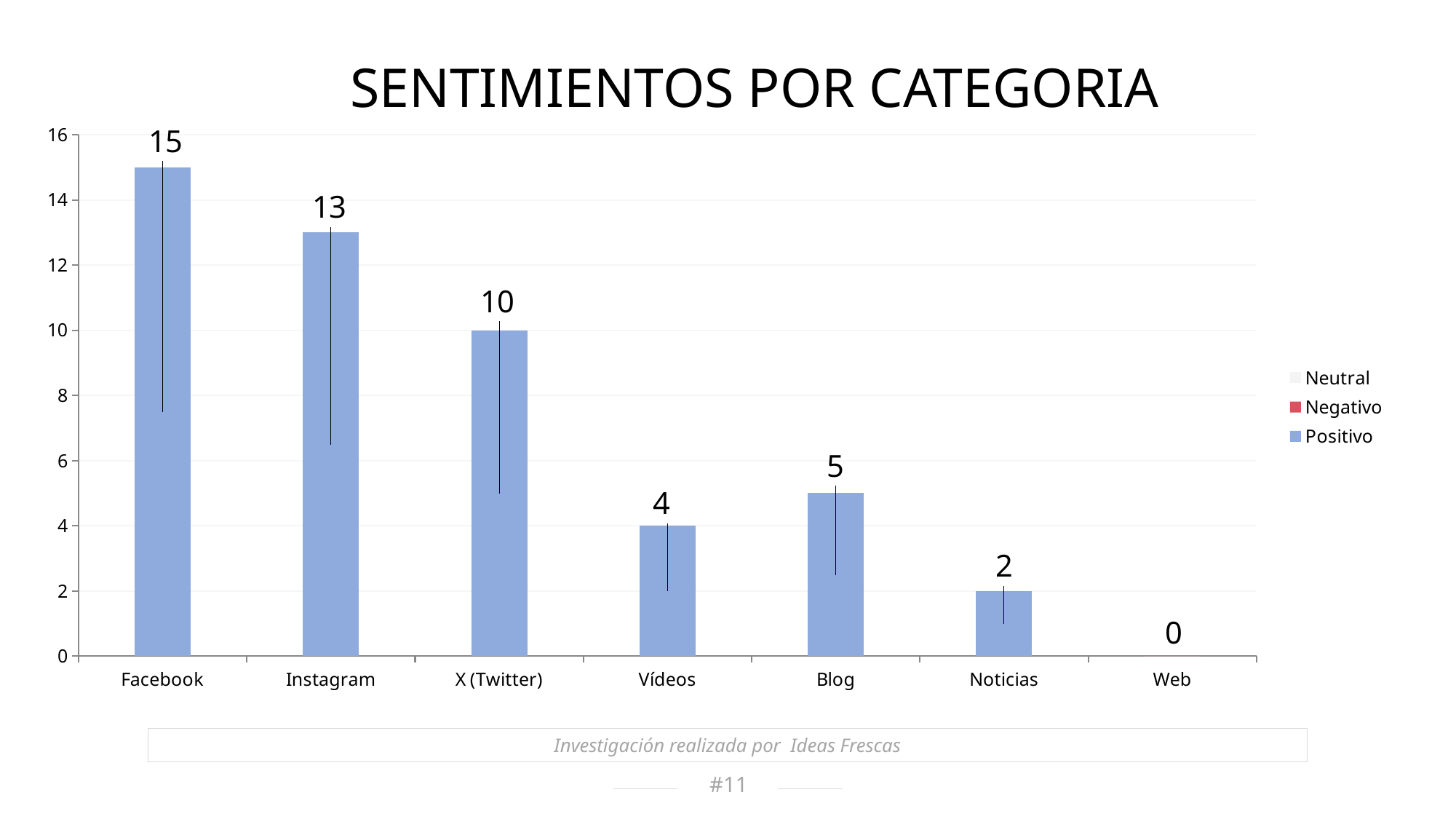
Which category has the highest value? Facebook What is the title of the chart? SENTIMIENTOS POR CATEGORIA What is the difference between the values for Facebook and Instagram? 2 What kind of chart is shown on the slide? Bar chart How many series does the legend list? 3 What is the value for X (Twitter)? 10 Which is larger, the value for Vídeos or the value for Blog? Blog What is the value for Noticias? 2 Which legend entry is shown in blue? Positivo What is the value for Facebook? 15 Which category has the lowest value? Web How many categories are shown on the x axis? 7